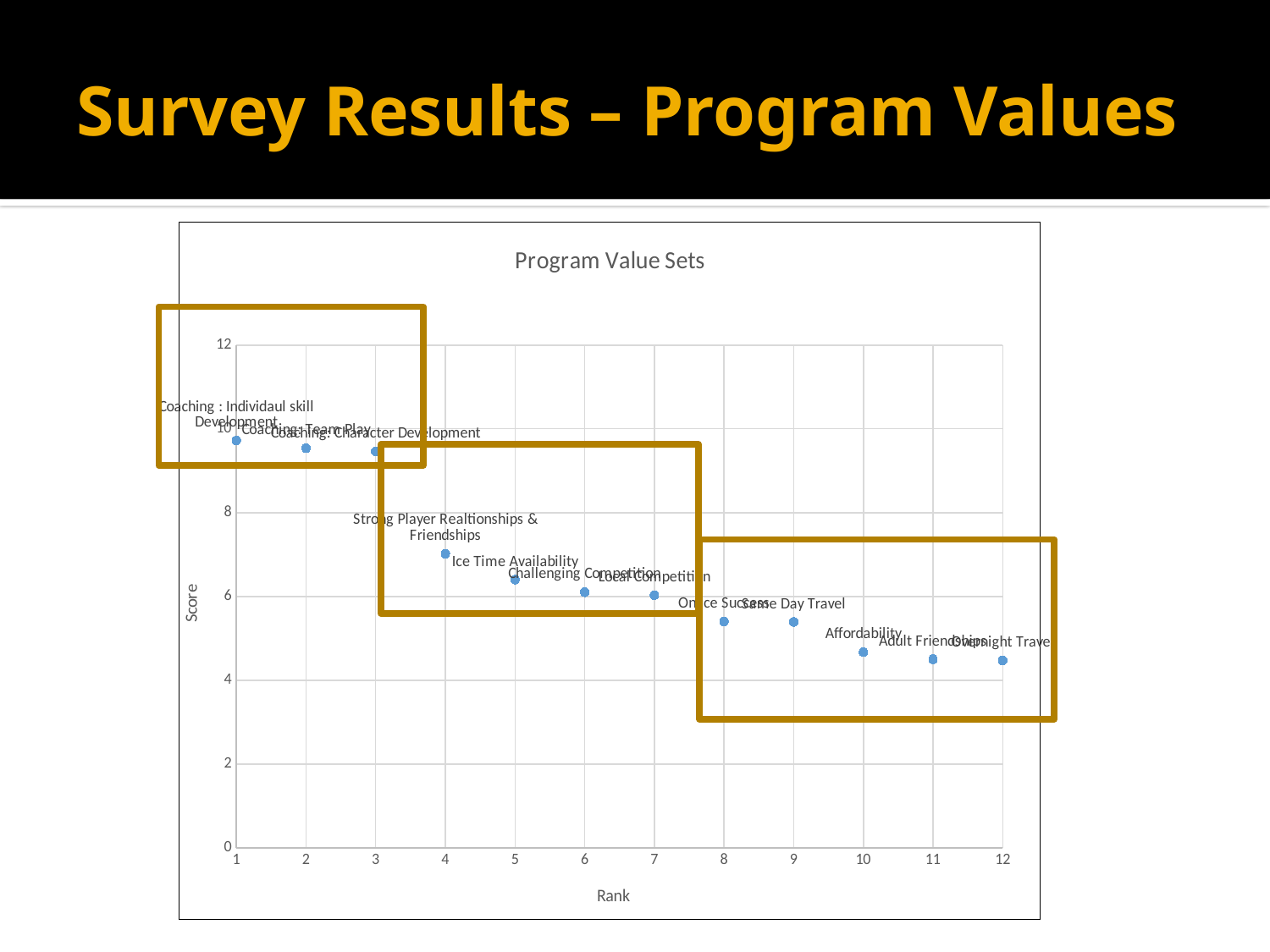
Which has the higher score, Strong Player Realtionships & Friendships or Affordability? Strong Player Realtionships & Friendships Is the score for Overnight Travel greater or less than 6? less What kind of chart is shown on the slide? Scatter chart Is the score for Coaching: Team Play greater or less than 8? greater What is the label of the x axis of the chart? Rank Do the scores rise or fall as rank increases along the x axis? Fall Is the score for On Ice Success greater or less than 6? less How many data points are plotted in the chart? 12 Which has the higher score, Coaching: Character Development or Ice Time Availability? Coaching: Character Development What is the title of the chart? Program Value Sets